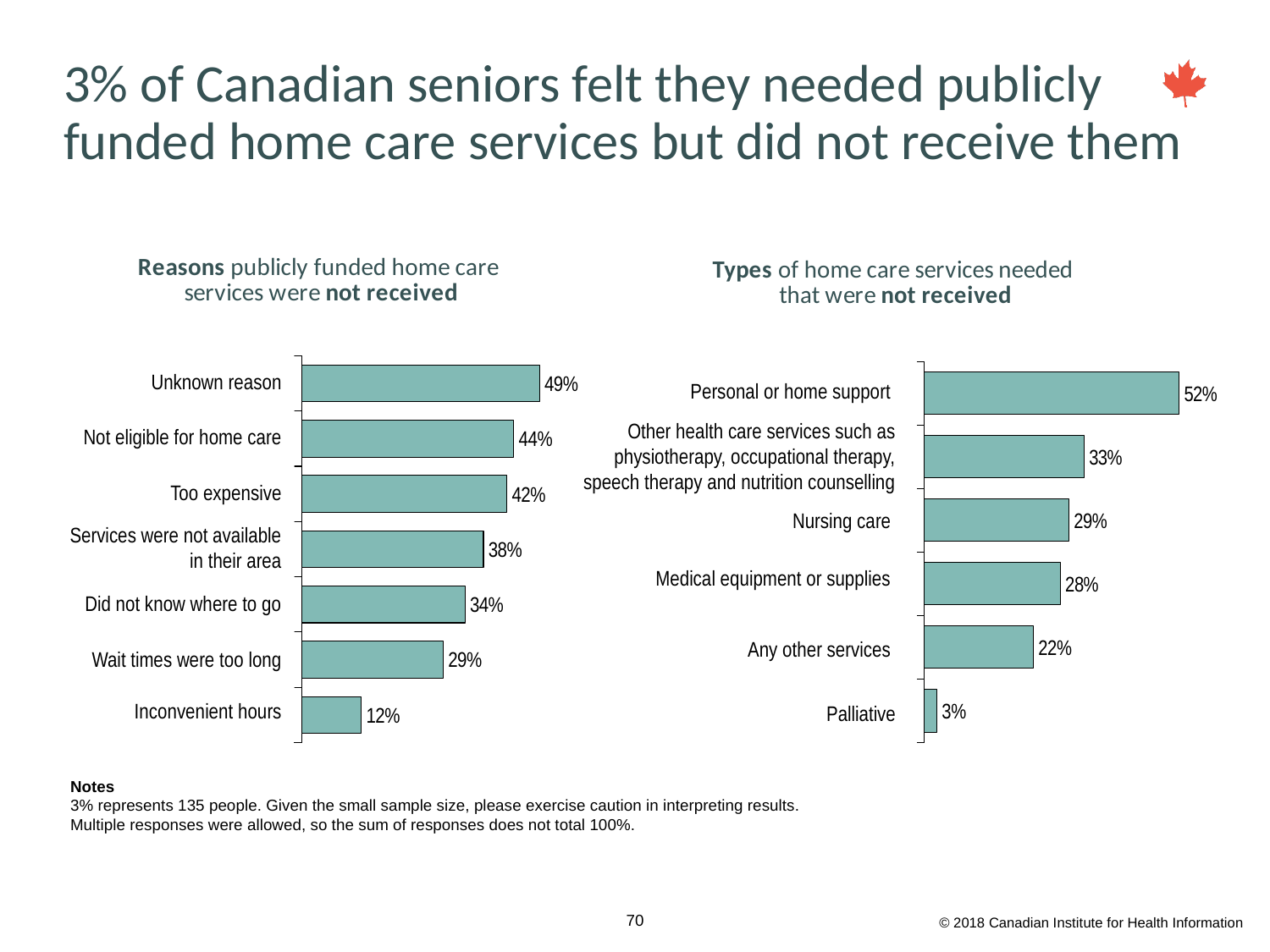
How many categories are shown in the 'Types of home care services needed that were not received' chart? 6 In the 'Types of home care services needed that were not received' chart, what is the difference between 'Personal or home support' and 'Any other services'? 30% In the 'Types of home care services needed that were not received' chart, which is larger: 'Medical equipment or supplies' or 'Other health care services such as physiotherapy, occupational therapy, speech therapy and nutrition counselling'? Other health care services such as physiotherapy, occupational therapy, speech therapy and nutrition counselling In the 'Types of home care services needed that were not received' chart, which category has the lowest value? Palliative In the 'Reasons publicly funded home care services were not received' chart, which is larger: 'Services were not available in their area' or 'Did not know where to go'? Services were not available in their area In the 'Reasons publicly funded home care services were not received' chart, which category has the highest value? Unknown reason In the 'Types of home care services needed that were not received' chart, what is the value for 'Nursing care'? 29% In the 'Reasons publicly funded home care services were not received' chart, what is the difference between 'Not eligible for home care' and 'Wait times were too long'? 15% What kind of chart is the 'Types of home care services needed that were not received' chart? Bar chart How many categories are shown in the 'Reasons publicly funded home care services were not received' chart? 7 In the 'Reasons publicly funded home care services were not received' chart, what is the value for 'Inconvenient hours'? 12% In the 'Reasons publicly funded home care services were not received' chart, what is the value for 'Too expensive'? 42%